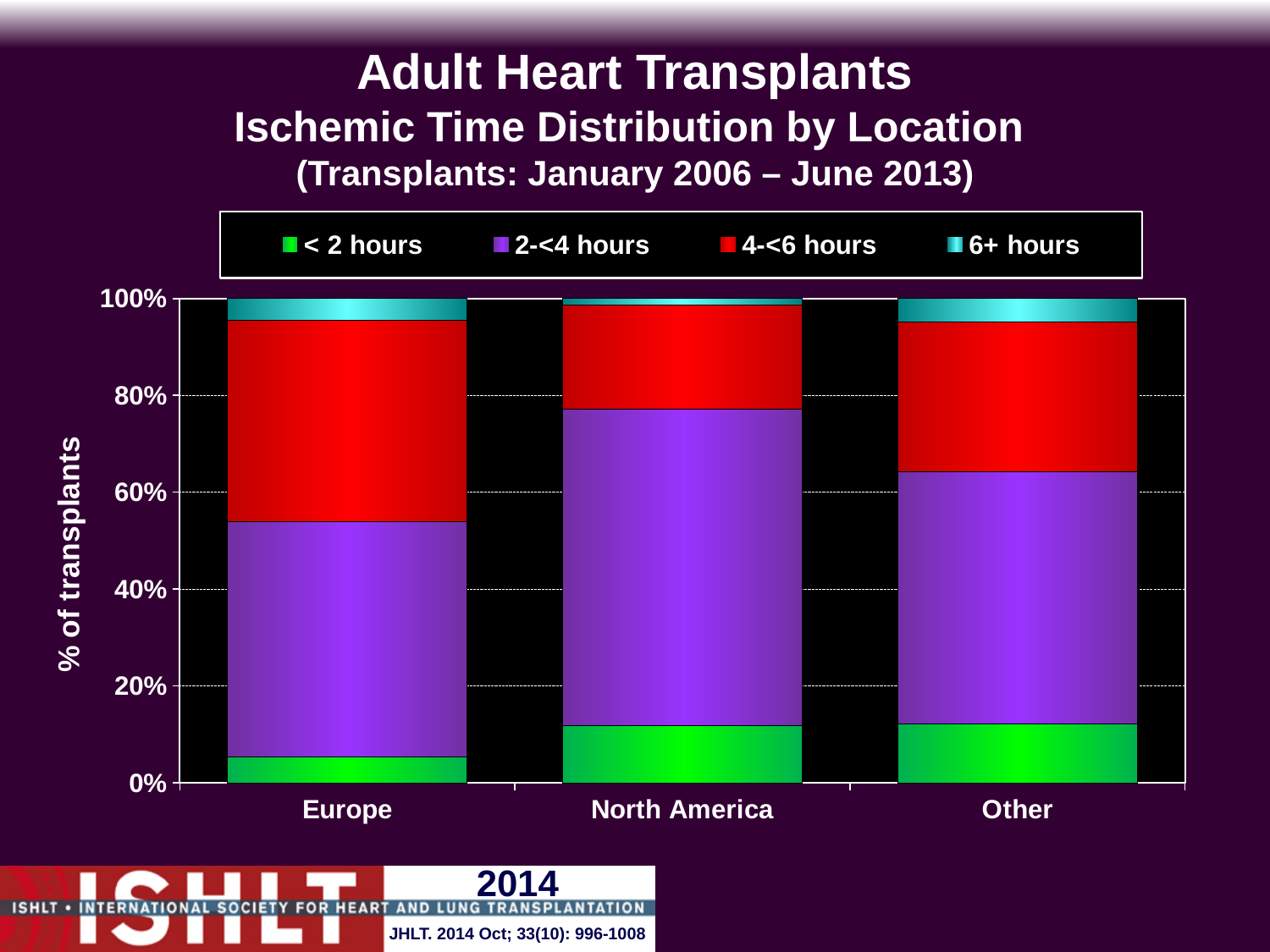
Is the value of the 2-<4 hours segment for North America greater or less than 60%? greater What is the label of the y axis? % of transplants Which location has the largest 4-<6 hours segment? Europe Which location has the largest 2-<4 hours segment? North America What kind of chart is shown on the slide? stacked bar chart Is the value of the < 2 hours segment for Europe greater or less than 20%? less Is the 2-<4 hours segment larger for Europe or for North America? North America Is the 4-<6 hours segment larger for Europe or for North America? Europe Is the value of the 4-<6 hours segment for Other greater or less than 40%? less Which location has the smallest < 2 hours segment? Europe How many locations are shown on the x axis of the chart? 3 How many series does the legend list? 4